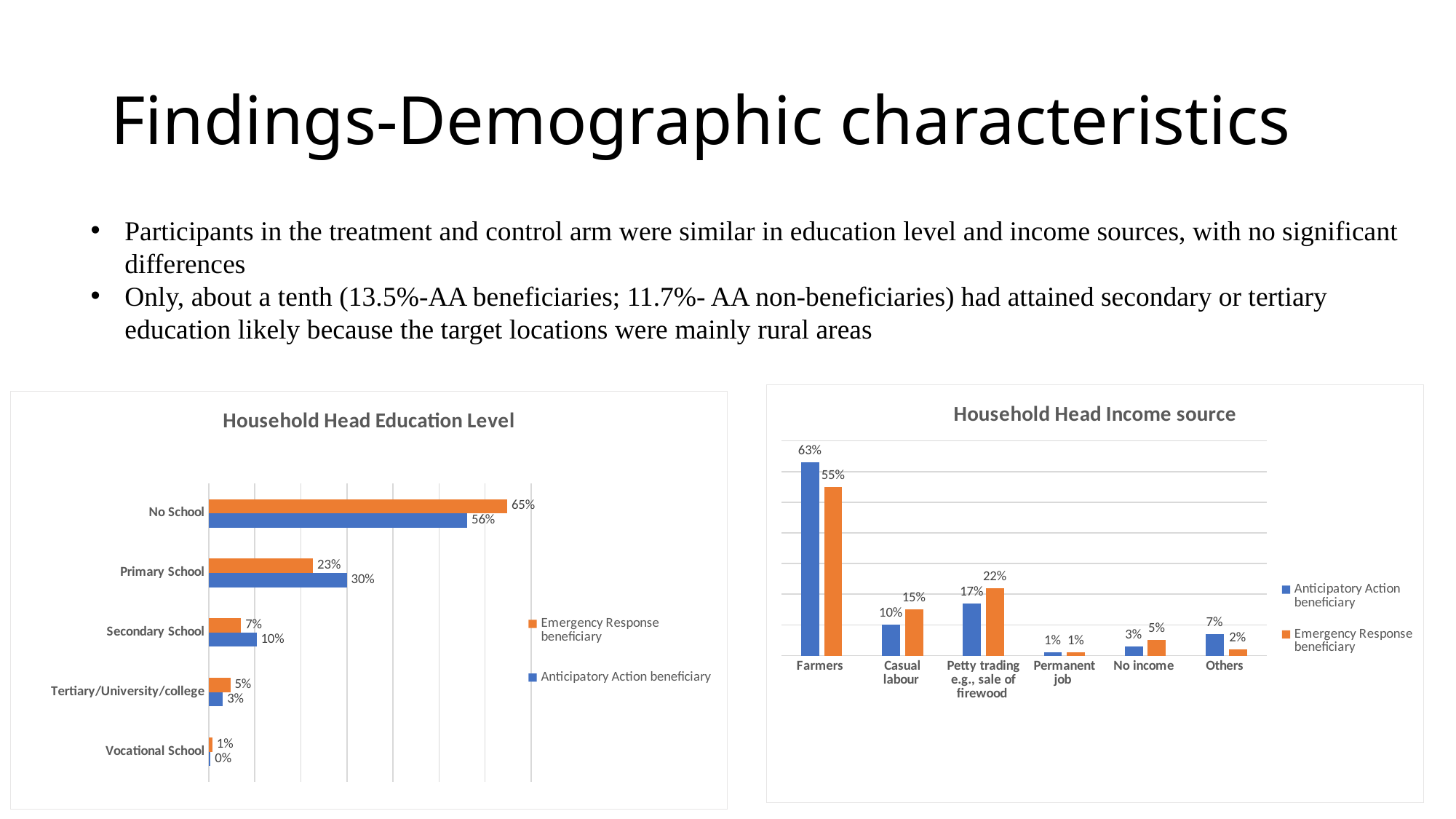
What kind of chart is the 'Household Head Education Level' chart? Bar chart In the 'Household Head Education Level' chart, what is the value for No School for Emergency Response beneficiary? 65% In the 'Household Head Income source' chart, which income source has the lowest value for Emergency Response beneficiary? Permanent job In the 'Household Head Income source' chart, what is the value for Farmers for Anticipatory Action beneficiary? 63% In the 'Household Head Income source' chart, what is the difference between the Anticipatory Action beneficiary and Emergency Response beneficiary values for Farmers? 8% In the 'Household Head Education Level' chart, what is the difference between the Emergency Response beneficiary and Anticipatory Action beneficiary values for No School? 9% How many series does the legend of the 'Household Head Income source' chart list? 2 In the 'Household Head Education Level' chart, which education level has the highest value for Anticipatory Action beneficiary? No School In the 'Household Head Income source' chart, which is larger for Casual labour: Anticipatory Action beneficiary or Emergency Response beneficiary? Emergency Response beneficiary In the 'Household Head Income source' chart, what is the value for Petty trading e.g., sale of firewood for Emergency Response beneficiary? 22% In the 'Household Head Education Level' chart, what is the value for Primary School for Anticipatory Action beneficiary? 30% In the 'Household Head Education Level' chart, how many education level categories are shown? 5